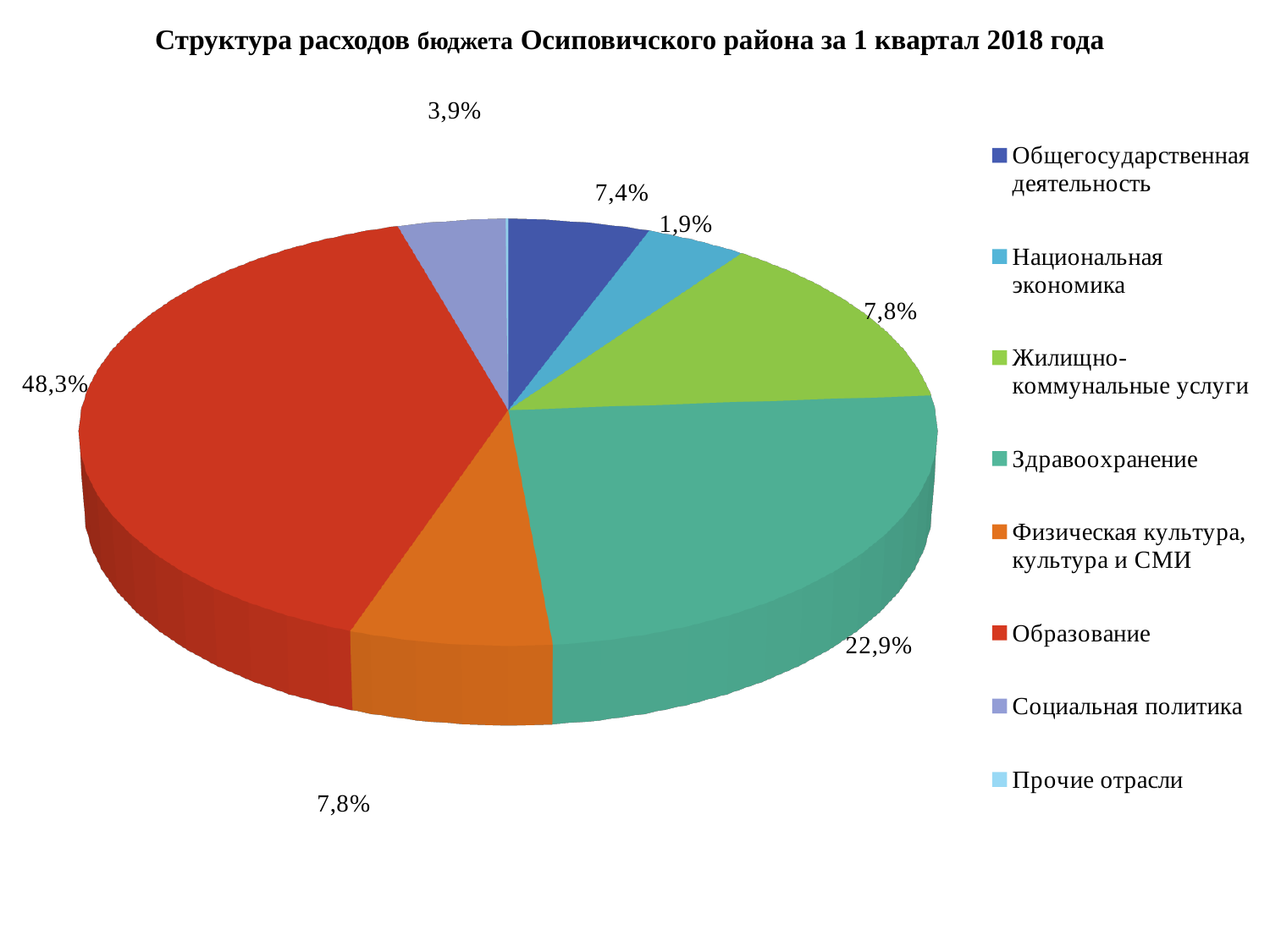
Which has the larger share: Здравоохранение or Физическая культура, культура и СМИ? Здравоохранение What share is shown for Социальная политика? 3,9% What share is shown for Национальная экономика? 1,9% What kind of chart is shown on the slide? pie chart What share of the budget expenditure goes to Здравоохранение? 22,9% What share of the budget expenditure goes to Образование? 48,3% What share is shown for Общегосударственная деятельность? 7,4% What share is shown for Жилищно-коммунальные услуги? 7,8% By how many percentage points does the share of Образование exceed the share of Здравоохранение? 25,4 How many categories does the legend list? 8 Which category has the largest share of the budget expenditure? Образование What is the title of the chart? Структура расходов бюджета Осиповичского района за 1 квартал 2018 года